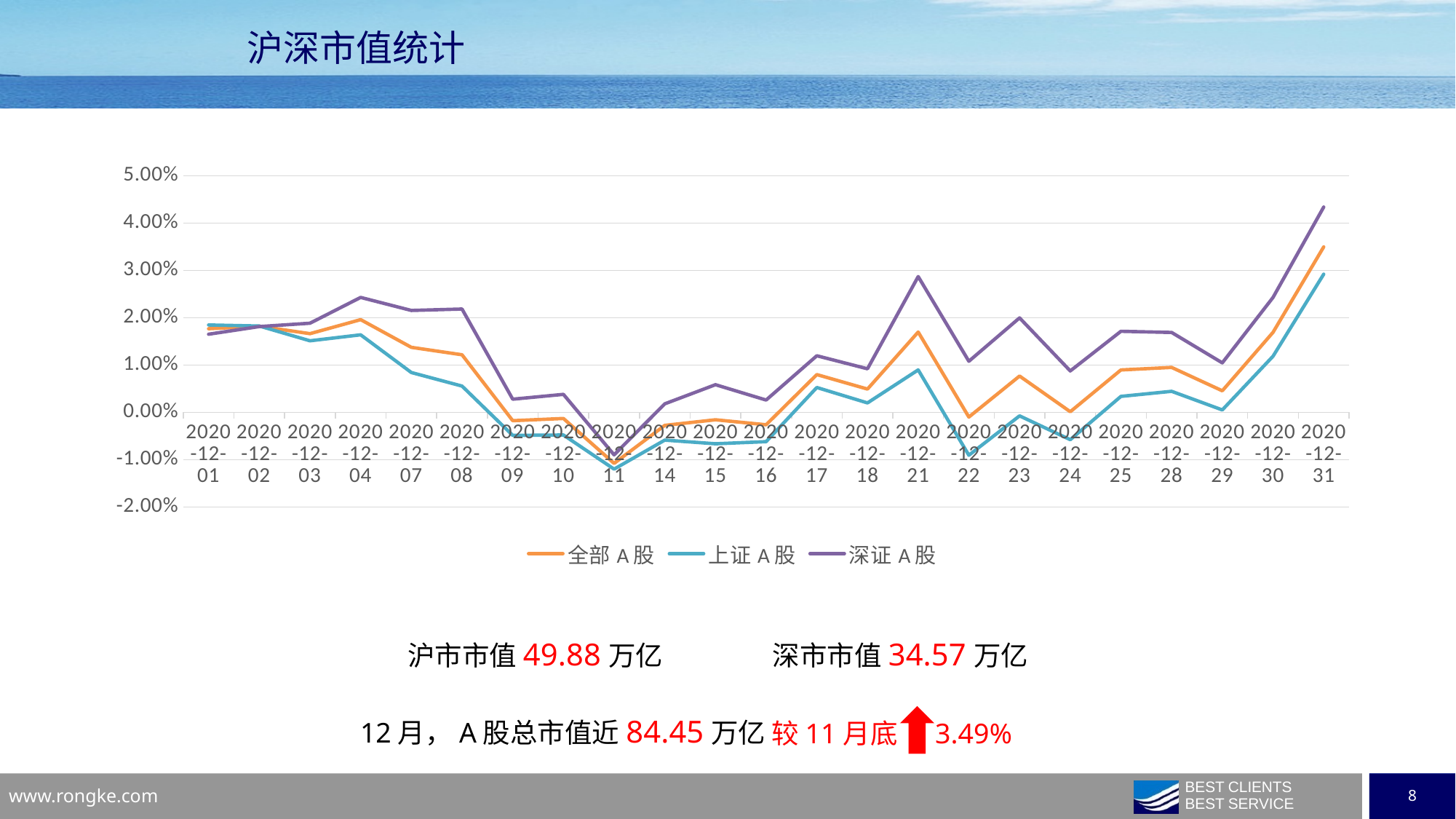
How many series does the chart legend list? 3 What kind of chart is shown on the slide? Line chart Which series in the chart is drawn in purple? 深证 A 股 Is the value for 深证 A 股 on 2020-12-31 greater or less than 4.00%? greater How many dates are plotted along the x axis of the chart? 23 Do the three series rise or fall from 2020-12-29 to 2020-12-31? Rise On which date does the 深证 A 股 series reach its highest value? 2020-12-31 Is the value for 上证 A 股 on 2020-12-11 greater or less than -1.00%? less What is the title of the slide containing the chart? 沪深市值统计 On which date does the 上证 A 股 series reach its lowest value? 2020-12-11 On 2020-12-21, which series has the larger value, 深证 A 股 or 全部 A 股? 深证 A 股 Is the value for 全部 A 股 on 2020-12-31 greater or less than 3.00%? greater